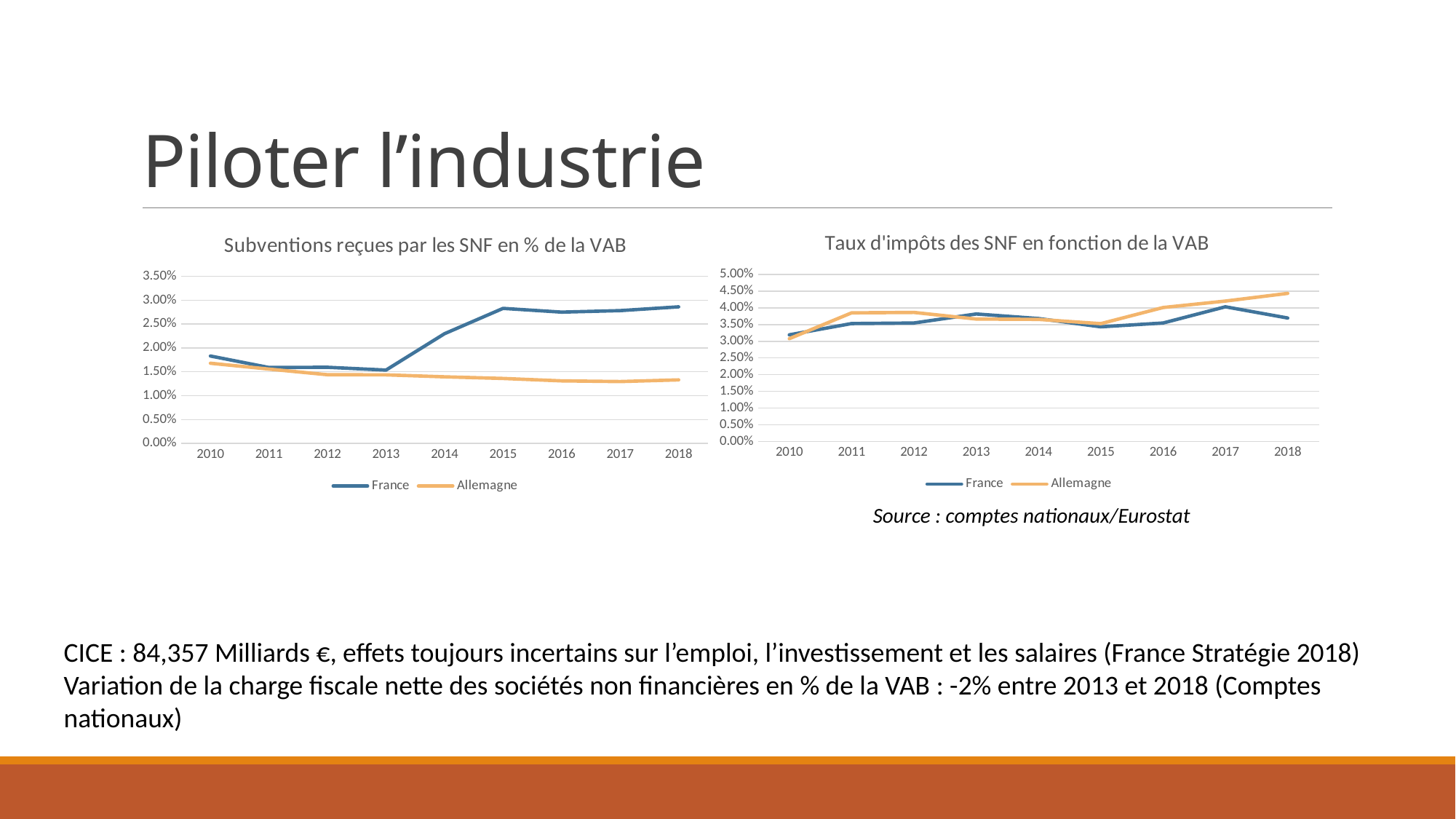
In the right chart 'Taux d'impôts des SNF en fonction de la VAB', which series has the higher value in 2018, France or Allemagne? Allemagne In the left chart 'Subventions reçues par les SNF en % de la VAB', is the value for Allemagne in 2018 greater or less than 1.50%? less In the left chart 'Subventions reçues par les SNF en % de la VAB', is the value for France in 2018 greater or less than 2.50%? greater How many years are plotted on the x axis of the left chart 'Subventions reçues par les SNF en % de la VAB'? 9 In the right chart 'Taux d'impôts des SNF en fonction de la VAB', does the Allemagne line rise or fall overall from 2010 to 2018? rise In the left chart 'Subventions reçues par les SNF en % de la VAB', does the Allemagne line rise or fall from 2010 to 2018? fall In the right chart 'Taux d'impôts des SNF en fonction de la VAB', is the value for Allemagne in 2018 greater or less than 4.00%? greater In the left chart 'Subventions reçues par les SNF en % de la VAB', does the France line rise or fall overall from 2010 to 2018? rise What is the title of the right chart on the slide? Taux d'impôts des SNF en fonction de la VAB What kind of chart is the left chart titled 'Subventions reçues par les SNF en % de la VAB'? line chart How many series does the legend of the right chart 'Taux d'impôts des SNF en fonction de la VAB' list? 2 In the left chart 'Subventions reçues par les SNF en % de la VAB', which series has the higher value in 2018, France or Allemagne? France